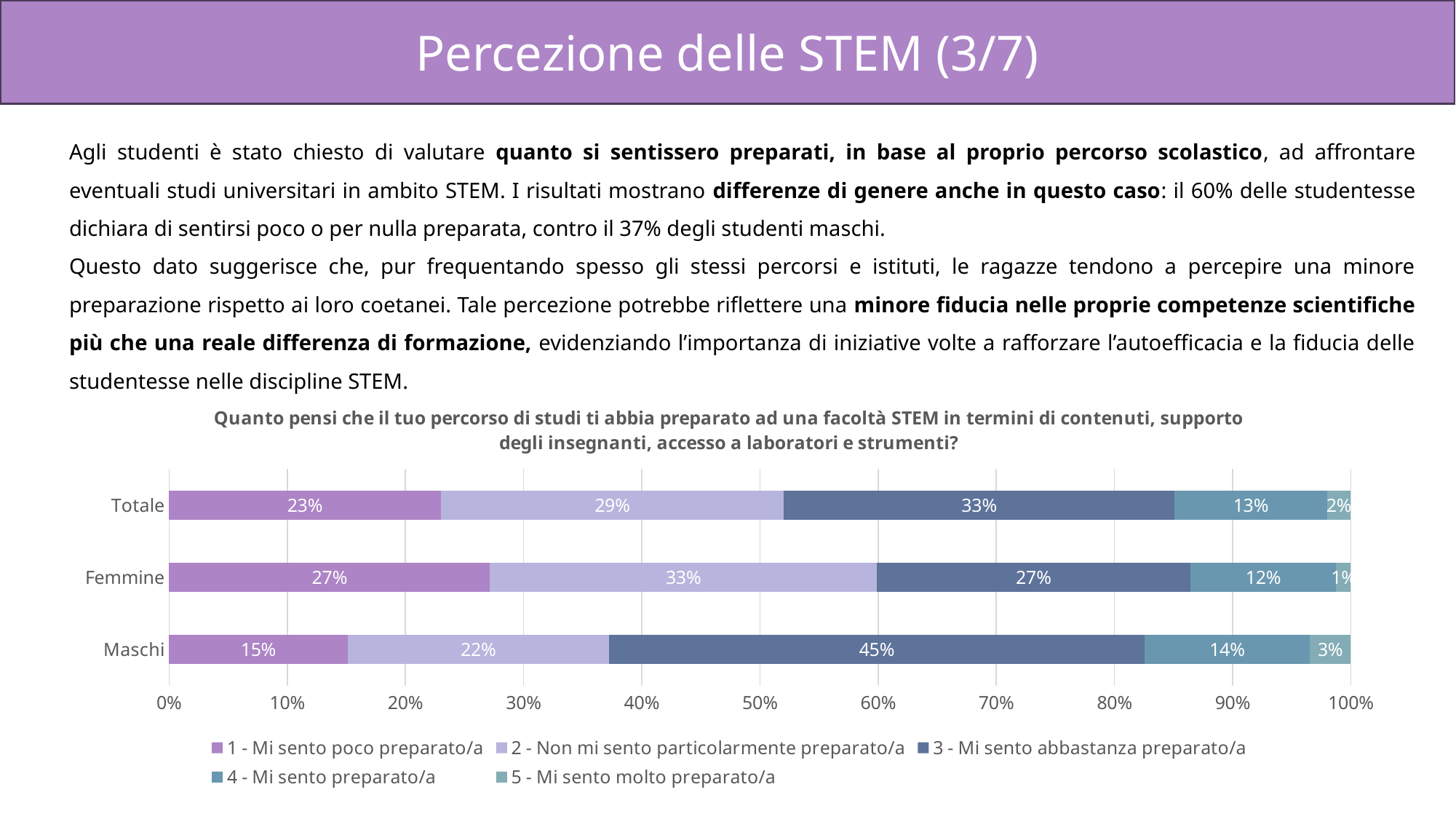
Which is larger: the "2 - Non mi sento particolarmente preparato/a" value for Femmine or for Maschi? Femmine Which category has the highest value for "3 - Mi sento abbastanza preparato/a"? Maschi How many series does the legend list? 5 What is the value for "2 - Non mi sento particolarmente preparato/a" for Totale? 29% Which category has the lowest value for "1 - Mi sento poco preparato/a"? Maschi What is the value for "5 - Mi sento molto preparato/a" for Maschi? 3% What is the combined share of "1 - Mi sento poco preparato/a" and "2 - Non mi sento particolarmente preparato/a" for Femmine? 60% What is the value for "3 - Mi sento abbastanza preparato/a" for Maschi? 45% What kind of chart is shown on the slide? Stacked bar chart What is the value for "1 - Mi sento poco preparato/a" for Femmine? 27% What is the difference between the "1 - Mi sento poco preparato/a" values for Femmine and Maschi? 12% How many categories are plotted on the chart? 3